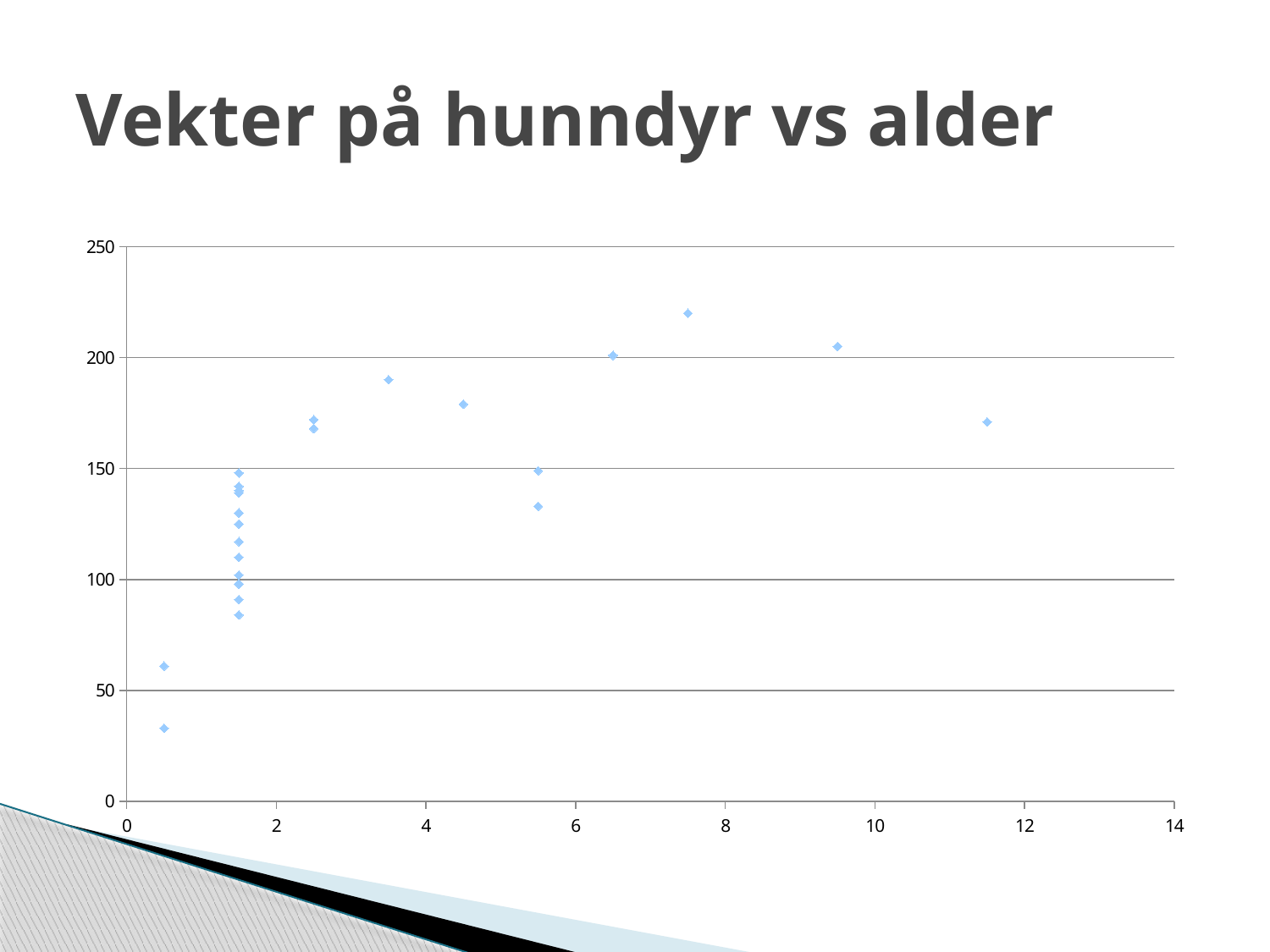
What is the highest value shown on the vertical axis? 250 Is the value of the lower point at x = 5.5 greater or less than 150? less Which point has the larger value: the one at x = 3.5 or the one at x = 4.5? x = 3.5 At which x value is the lowest point on the chart located? 0.5 Is the value of the point at x = 4.5 greater or less than 150? greater Is the value of the point at x = 11.5 greater or less than 200? less At which x value is the highest point on the chart located? 7.5 What kind of chart is shown on the slide? scatter plot What is the title of the chart? Vekter på hunndyr vs alder